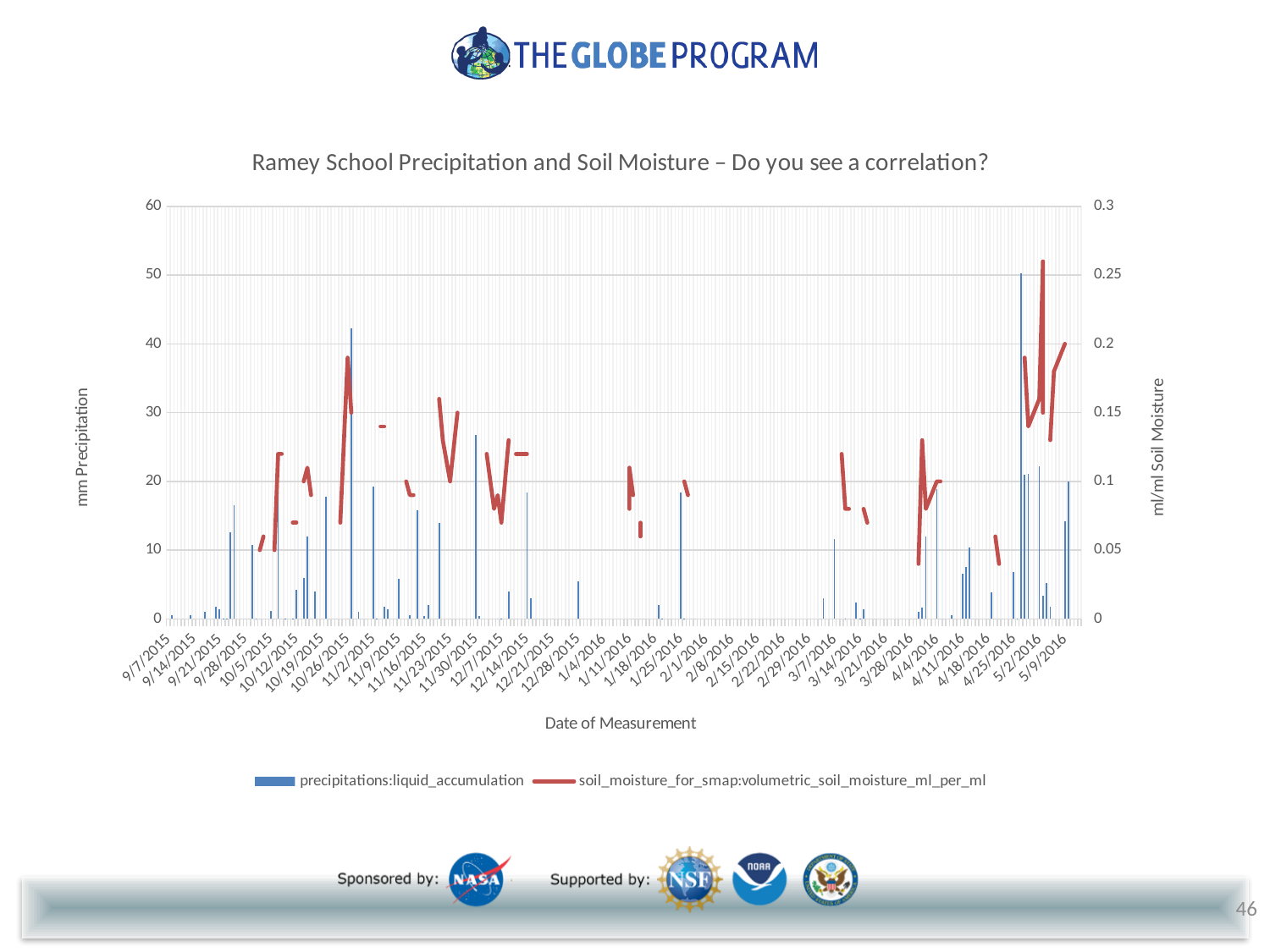
Is the highest soil moisture value, near 5/2/2016, greater or less than 0.2 ml/ml? greater Is the precipitation bar near 11/30/2015 greater or less than 20 mm? greater What is the label of the right-hand vertical axis? ml/ml Soil Moisture What kind of chart is shown on the slide? A combined bar and line chart Is the soil moisture value near 10/26/2015 greater or less than 0.15 ml/ml? greater What is the maximum value shown on the left vertical axis (mm Precipitation)? 60 What is the title of the chart? Ramey School Precipitation and Soil Moisture – Do you see a correlation? What is the maximum value shown on the right vertical axis (ml/ml Soil Moisture)? 0.3 How many series does the legend list? 2